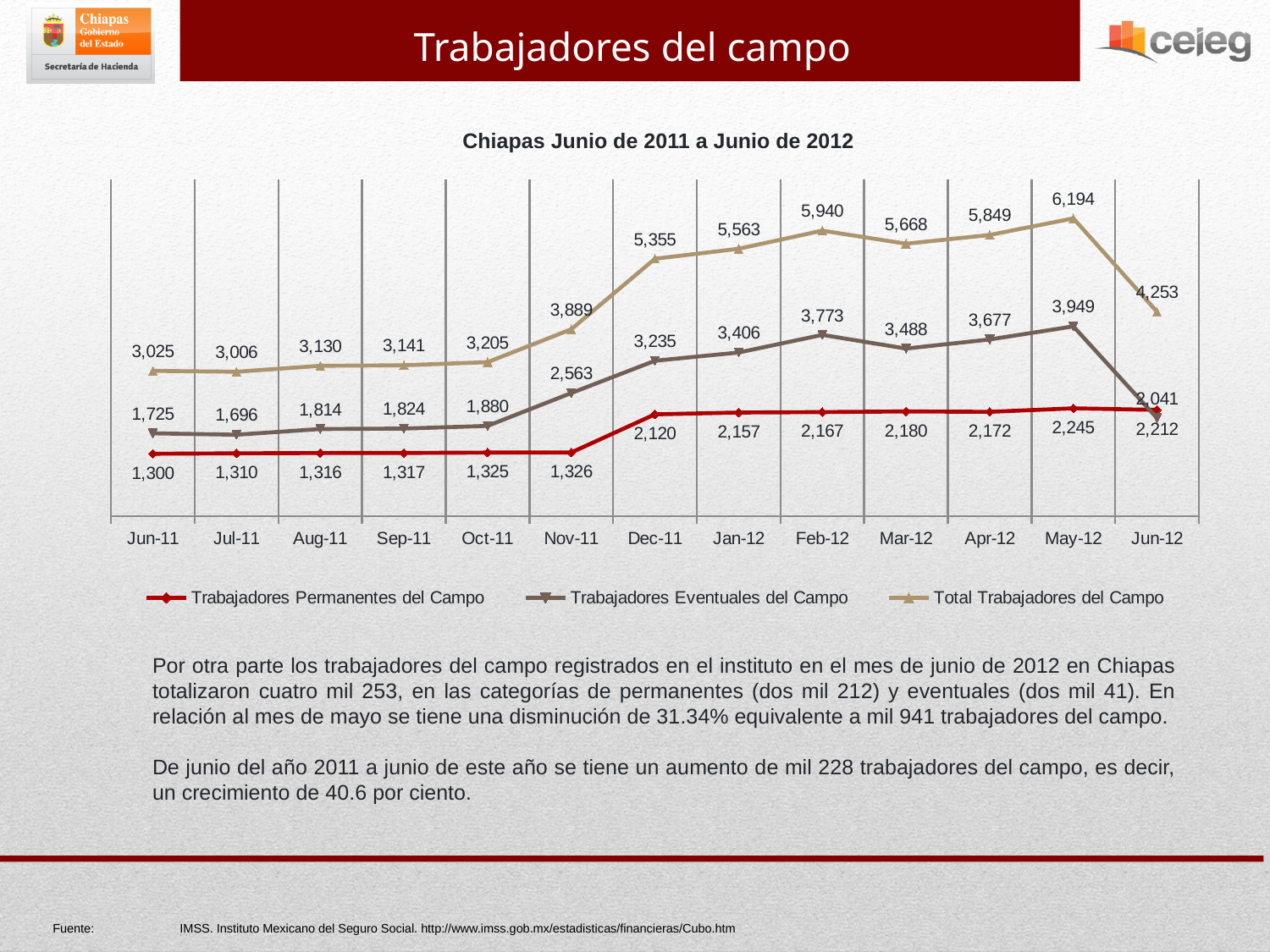
What type of chart is shown on the slide? Line chart What is the value of Total Trabajadores del Campo in May-12? 6,194 In which month is Trabajadores Eventuales del Campo lowest? Jul-11 How many series does the legend list? 3 What is the title of the chart? Chiapas Junio de 2011 a Junio de 2012 How many months are plotted along the x axis? 13 Which is larger in Jun-12: Trabajadores Permanentes del Campo or Trabajadores Eventuales del Campo? Trabajadores Permanentes del Campo What is the value of Trabajadores Permanentes del Campo in Jun-11? 1,300 Does Trabajadores Permanentes del Campo rise or fall from Jun-11 to May-12? Rise In which month is Total Trabajadores del Campo highest? May-12 What is the value of Trabajadores Eventuales del Campo in Feb-12? 3,773 What is the difference between Total Trabajadores del Campo in May-12 and Jun-12? 1,941